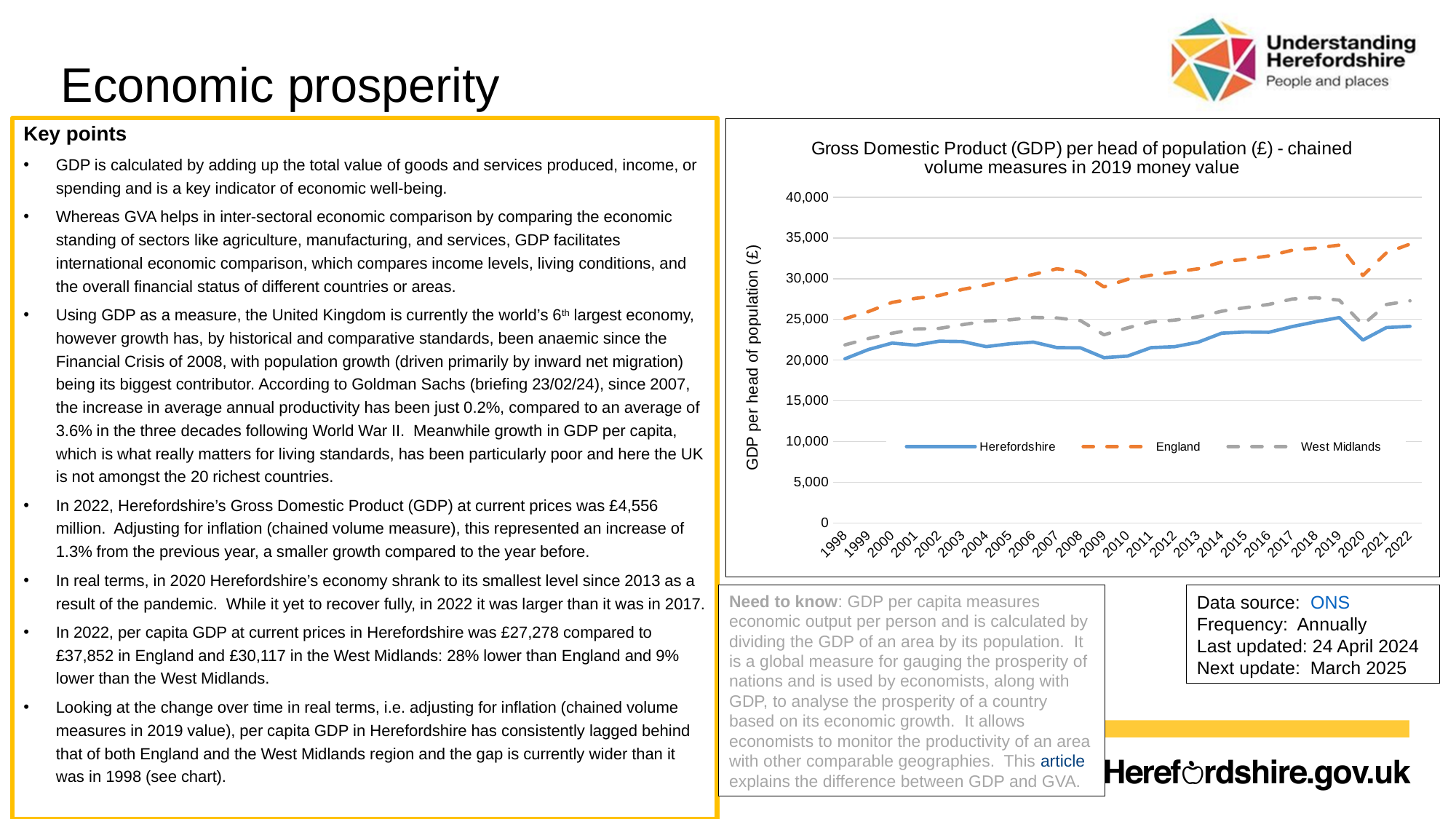
How many series does the chart's legend list? 3 In 2010, which is larger: the value for Herefordshire or the value for West Midlands? West Midlands Is the value for England in 2009 greater or less than 30,000? less Which area has the highest GDP per head of population in 2022? England Does the value for England rise or fall between 2019 and 2020? Fall Is the value for Herefordshire in 2020 greater or less than 25,000? less How many years are plotted along the x axis of the chart? 25 What is the label on the vertical axis of the chart? GDP per head of population (£) Is the value for England in 2022 greater or less than 30,000? greater Which area has the lowest GDP per head of population in 2022? Herefordshire What kind of chart is shown on the slide? Line chart